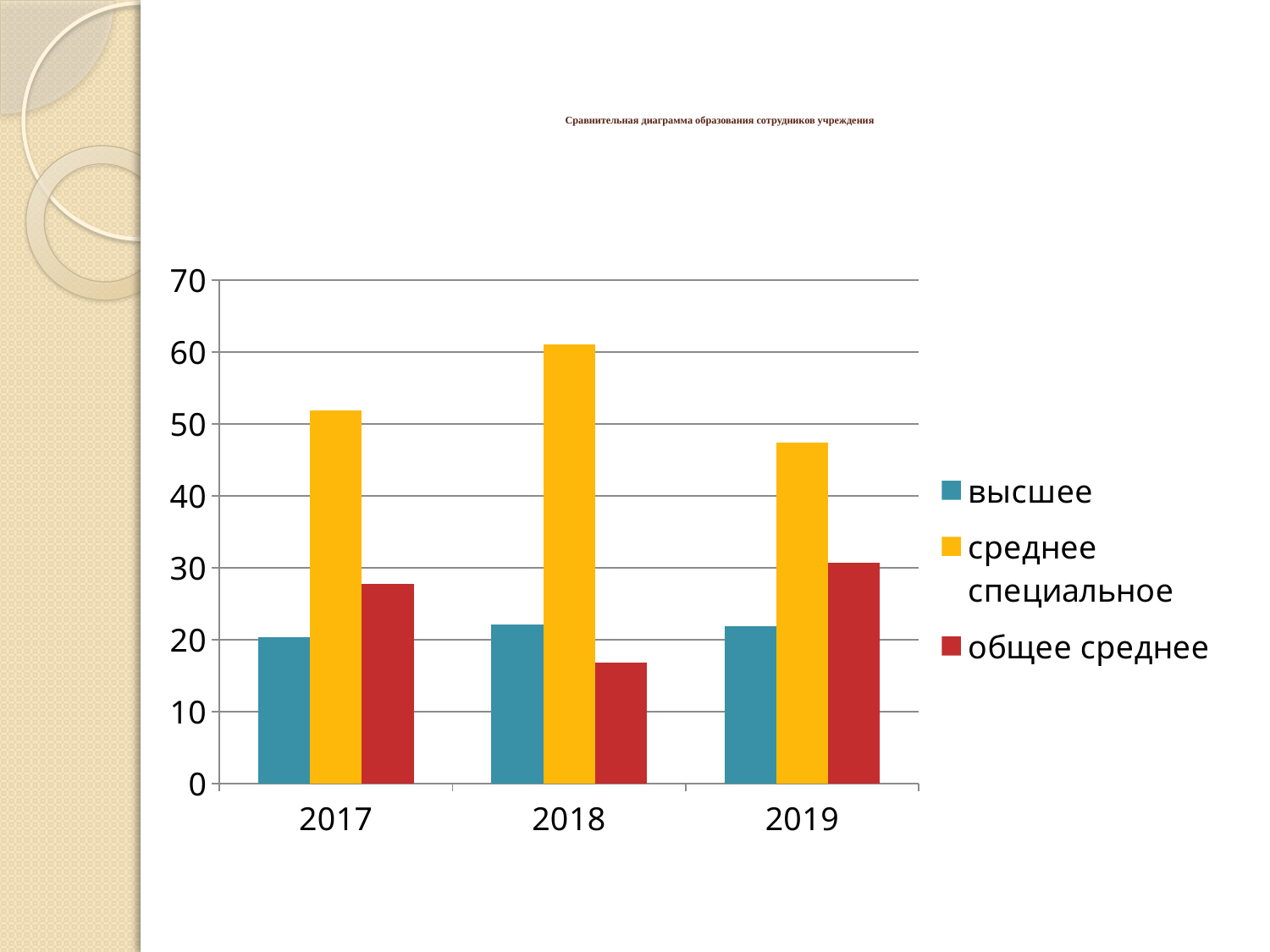
In 2018, which is larger: высшее or общее среднее? высшее How many years are shown on the x axis? 3 Is the value for среднее специальное in 2019 greater or less than 50? less In 2017, which is larger: высшее or общее среднее? общее среднее What kind of chart is shown on the slide? bar chart Does the value for среднее специальное rise or fall from 2018 to 2019? fall In which year is the value for среднее специальное highest? 2018 In which year is the value for общее среднее lowest? 2018 Is the value for среднее специальное in 2018 greater or less than 50? greater How many series does the legend list? 3 Is the value for общее среднее in 2018 greater or less than 20? less